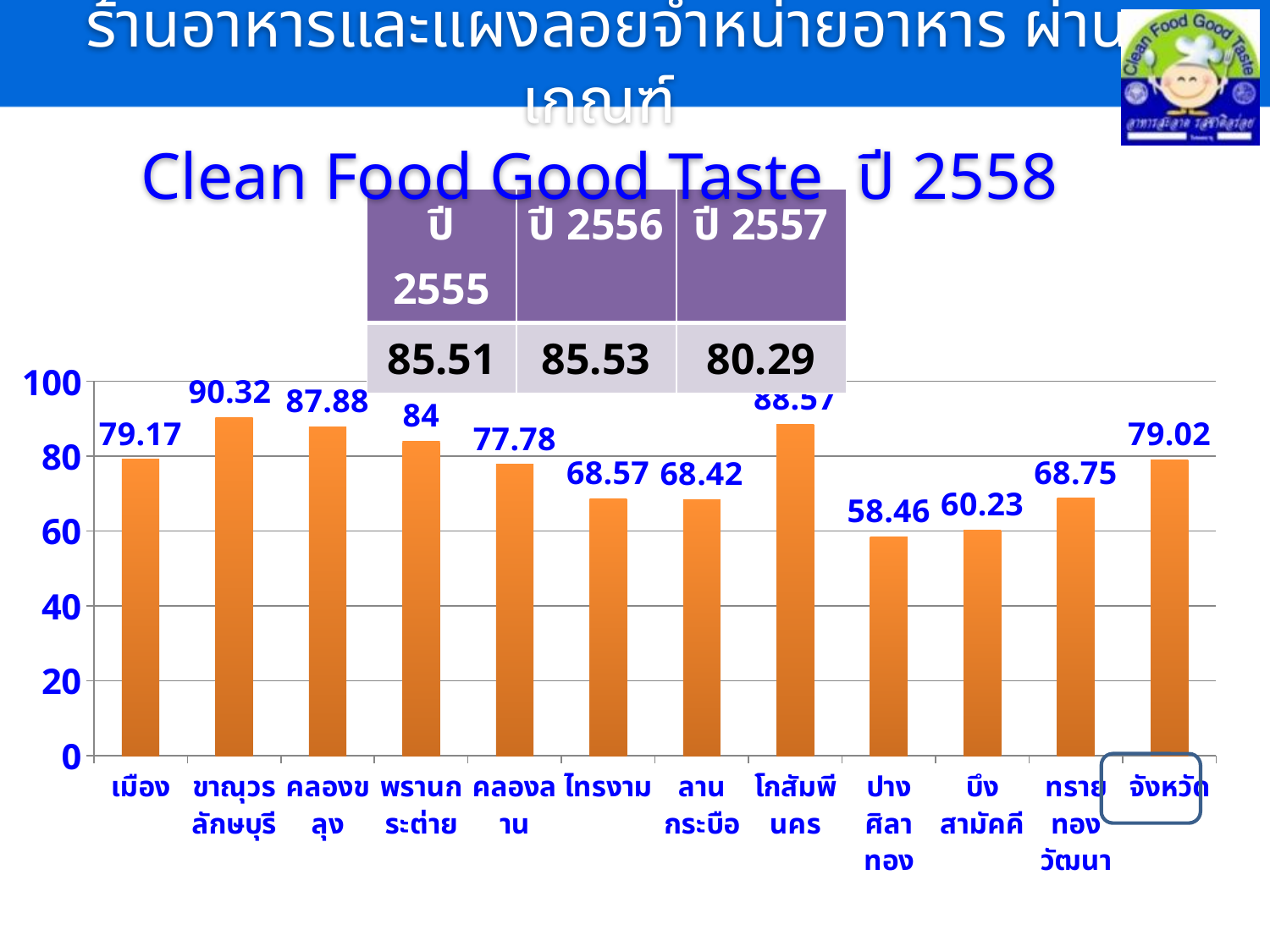
Which is larger, the value for พรานกระต่าย or the value for ไทรงาม? พรานกระต่าย What kind of chart is shown on the slide? bar chart Which category has the highest value? ขาณุวรลักษบุรี What is the value for จังหวัด? 79.02 What is the difference between the values for คลองขลุง and คลองลาน? 10.1 What is the value for ขาณุวรลักษบุรี? 90.32 What colour are the bars in the chart? orange How many categories are shown on the x axis? 12 What is the value for ปางศิลาทอง? 58.46 What is the value for เมือง? 79.17 Which category has the lowest value? ปางศิลาทอง Is the value for บึงสามัคคี greater or less than 80? less